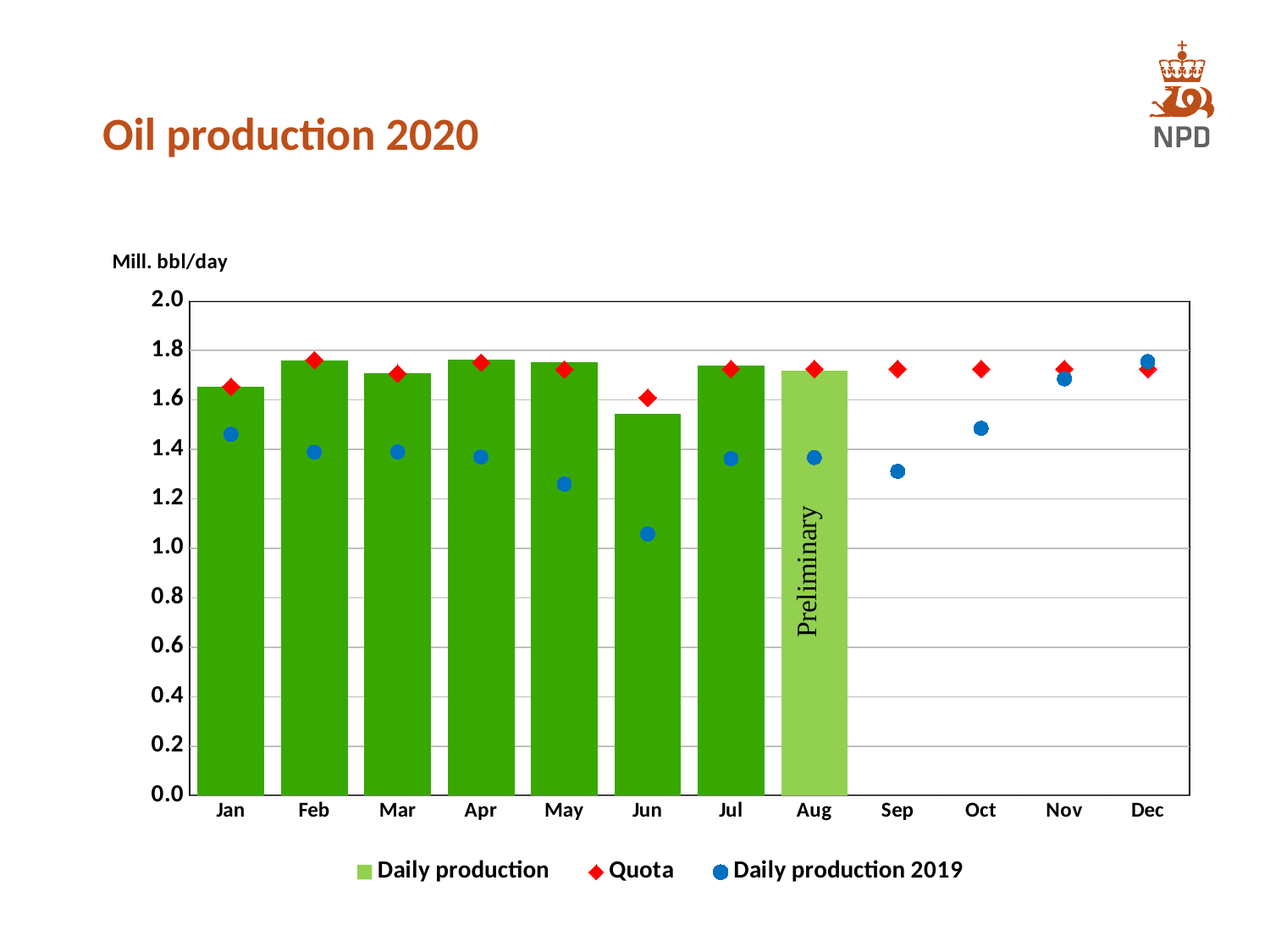
Which month has the lowest Quota value? Jun Which month has the highest Daily production 2019 value? Dec Is the Daily production value for Jun greater or less than 1.6? less Which bar is labelled 'Preliminary'? Aug How many months have a Daily production bar plotted? 8 How many series does the legend list? 3 How many months are shown on the x axis? 12 What kind of chart is shown on the slide? bar chart Which month has the lowest Daily production bar? Jun Which is larger in Jun, the Quota or the Daily production bar? Quota Is the Daily production 2019 value for Sep greater or less than 1.4? less Which month has the lowest Daily production 2019 value? Jun